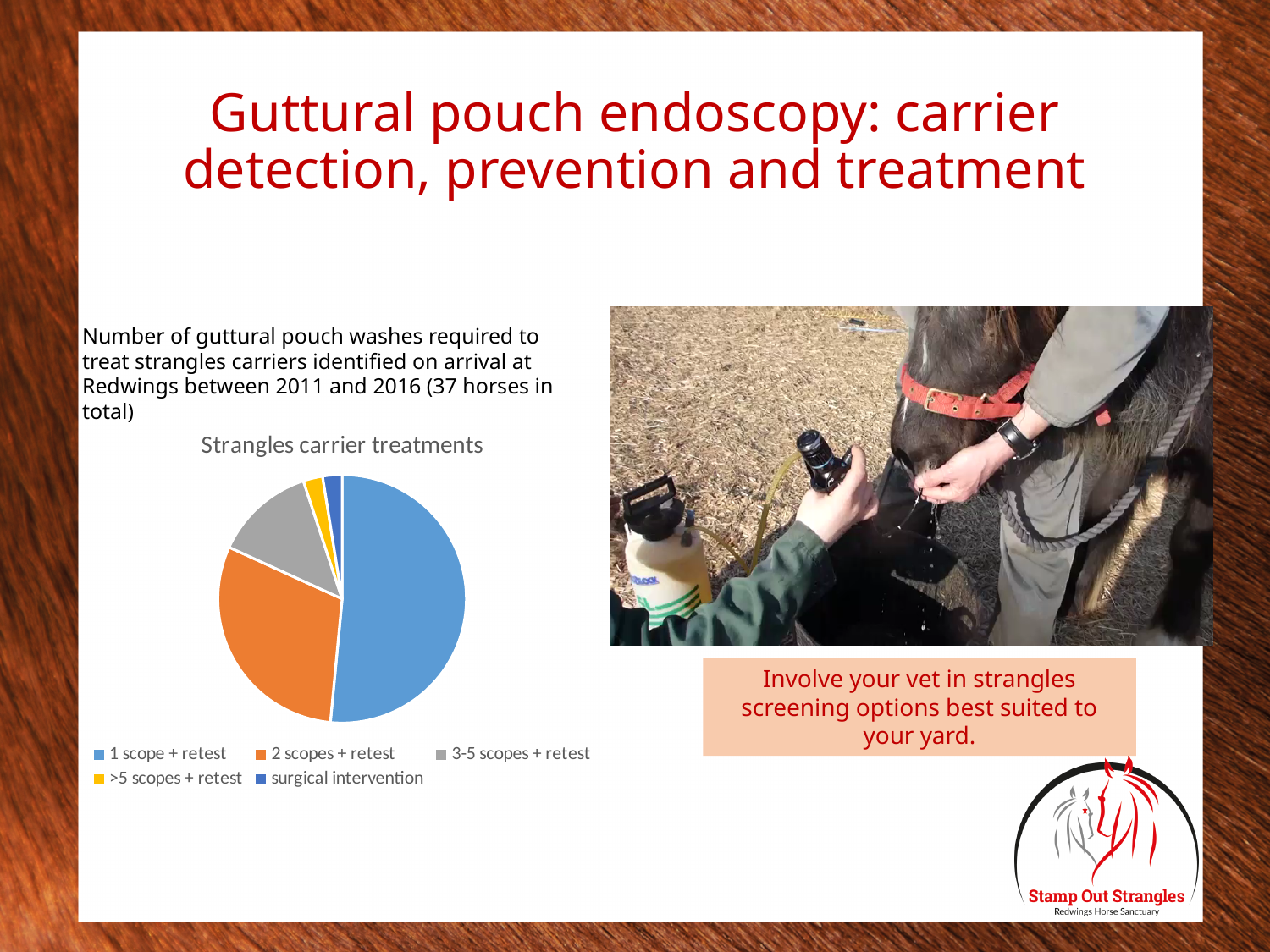
Which category has the largest slice of the pie chart? 1 scope + retest Which slice is larger: 2 scopes + retest or 3-5 scopes + retest? 2 scopes + retest What colour is the slice for 2 scopes + retest in the pie chart? orange Which slice is larger: 3-5 scopes + retest or surgical intervention? 3-5 scopes + retest How many slices does the pie chart have? 5 What kind of chart is shown on the slide? pie chart How many categories does the pie chart's legend list? 5 What is the title of the pie chart? Strangles carrier treatments Which slice is larger: 1 scope + retest or 3-5 scopes + retest? 1 scope + retest